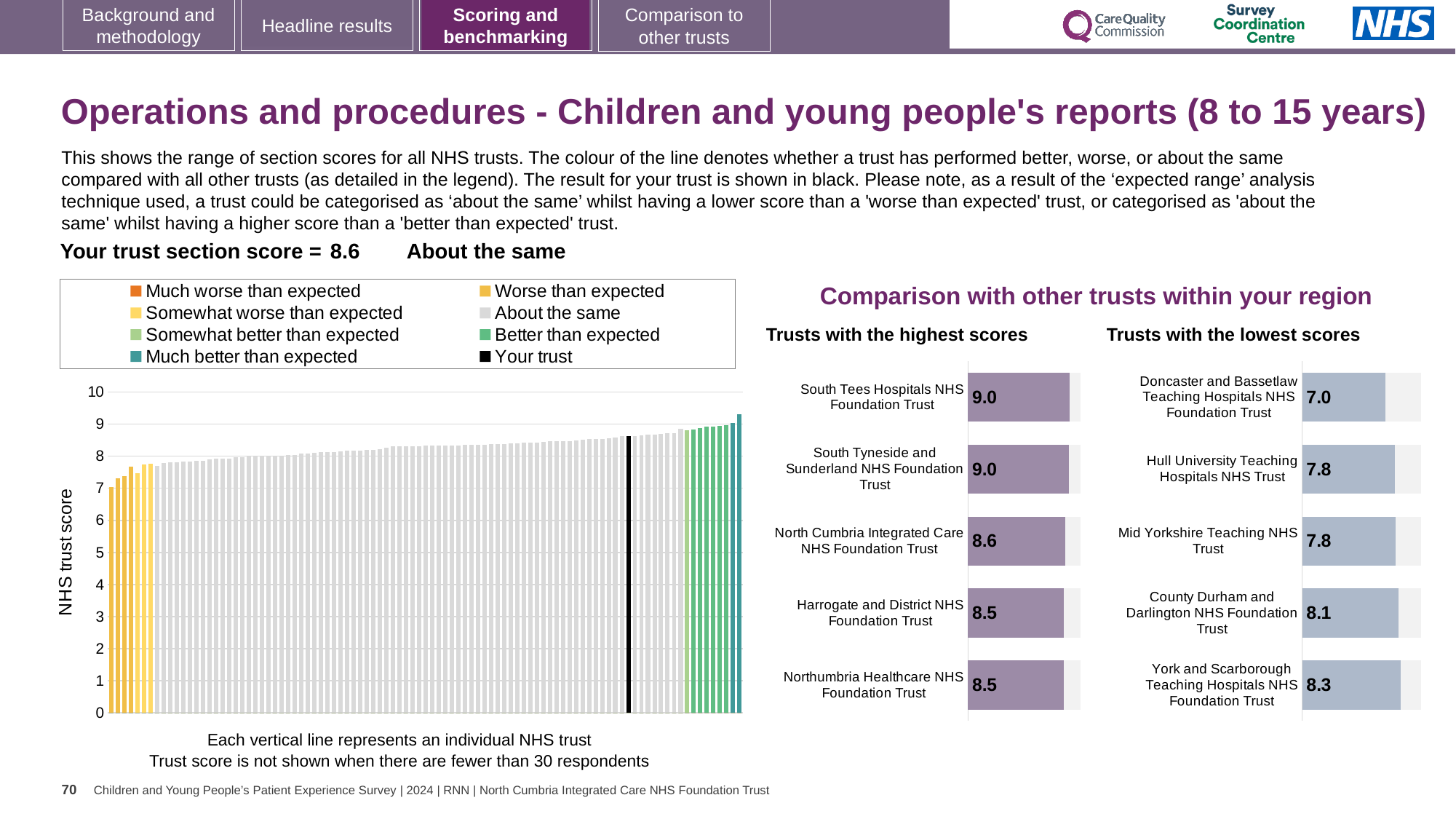
In the NHS trust score chart on the left, do the bar values rise or fall from left to right? rise In the 'Trusts with the lowest scores' chart, which trust has the lowest score? Doncaster and Bassetlaw Teaching Hospitals NHS Foundation Trust In the NHS trust score chart on the left, is the value for the black 'Your trust' bar greater or less than 8? greater In the 'Trusts with the lowest scores' chart, which has the larger score: County Durham and Darlington NHS Foundation Trust or Doncaster and Bassetlaw Teaching Hospitals NHS Foundation Trust? County Durham and Darlington NHS Foundation Trust In the 'Trusts with the lowest scores' chart, what is the difference between the scores of York and Scarborough Teaching Hospitals NHS Foundation Trust and Doncaster and Bassetlaw Teaching Hospitals NHS Foundation Trust? 1.3 In the 'Trusts with the highest scores' chart, what is the score for North Cumbria Integrated Care NHS Foundation Trust? 8.6 In the 'Trusts with the lowest scores' chart, what is the score for Hull University Teaching Hospitals NHS Trust? 7.8 In the 'Trusts with the highest scores' chart, what is the score for South Tees Hospitals NHS Foundation Trust? 9.0 In the 'Trusts with the lowest scores' chart, which trust has the highest score? York and Scarborough Teaching Hospitals NHS Foundation Trust In the 'Trusts with the highest scores' chart, what is the difference between the scores of South Tees Hospitals NHS Foundation Trust and Northumbria Healthcare NHS Foundation Trust? 0.5 How many entries does the legend of the NHS trust score chart on the left list? 8 How many trusts are shown in the 'Trusts with the highest scores' chart? 5